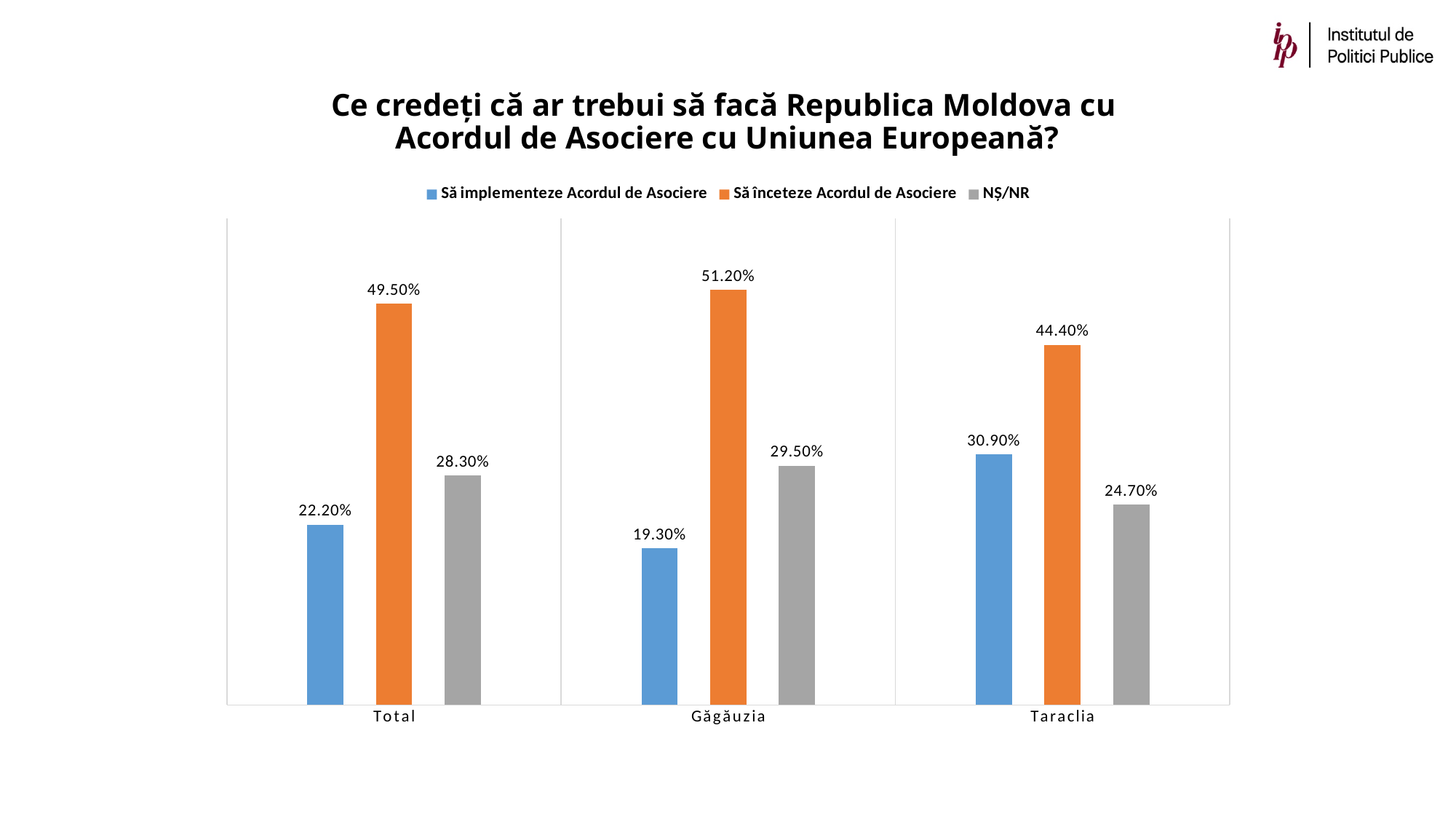
What is the value for "Să implementeze Acordul de Asociere" in Taraclia? 30.90% How many categories are shown on the x axis? 3 Which is larger in Taraclia: "Să implementeze Acordul de Asociere" or NȘ/NR? Să implementeze Acordul de Asociere How many series does the legend list? 3 What is the NȘ/NR value for Total? 28.30% Which category has the lowest value for "Să implementeze Acordul de Asociere"? Găgăuzia Which category has the highest value for "Să înceteze Acordul de Asociere"? Găgăuzia What kind of chart is shown on the slide? Bar chart What is the difference between the NȘ/NR values for Găgăuzia and Taraclia? 4.80% What is the value for "Să înceteze Acordul de Asociere" in Găgăuzia? 51.20% What is the difference between "Să înceteze Acordul de Asociere" and "Să implementeze Acordul de Asociere" for Total? 27.30% Which colour represents the NȘ/NR series? Grey